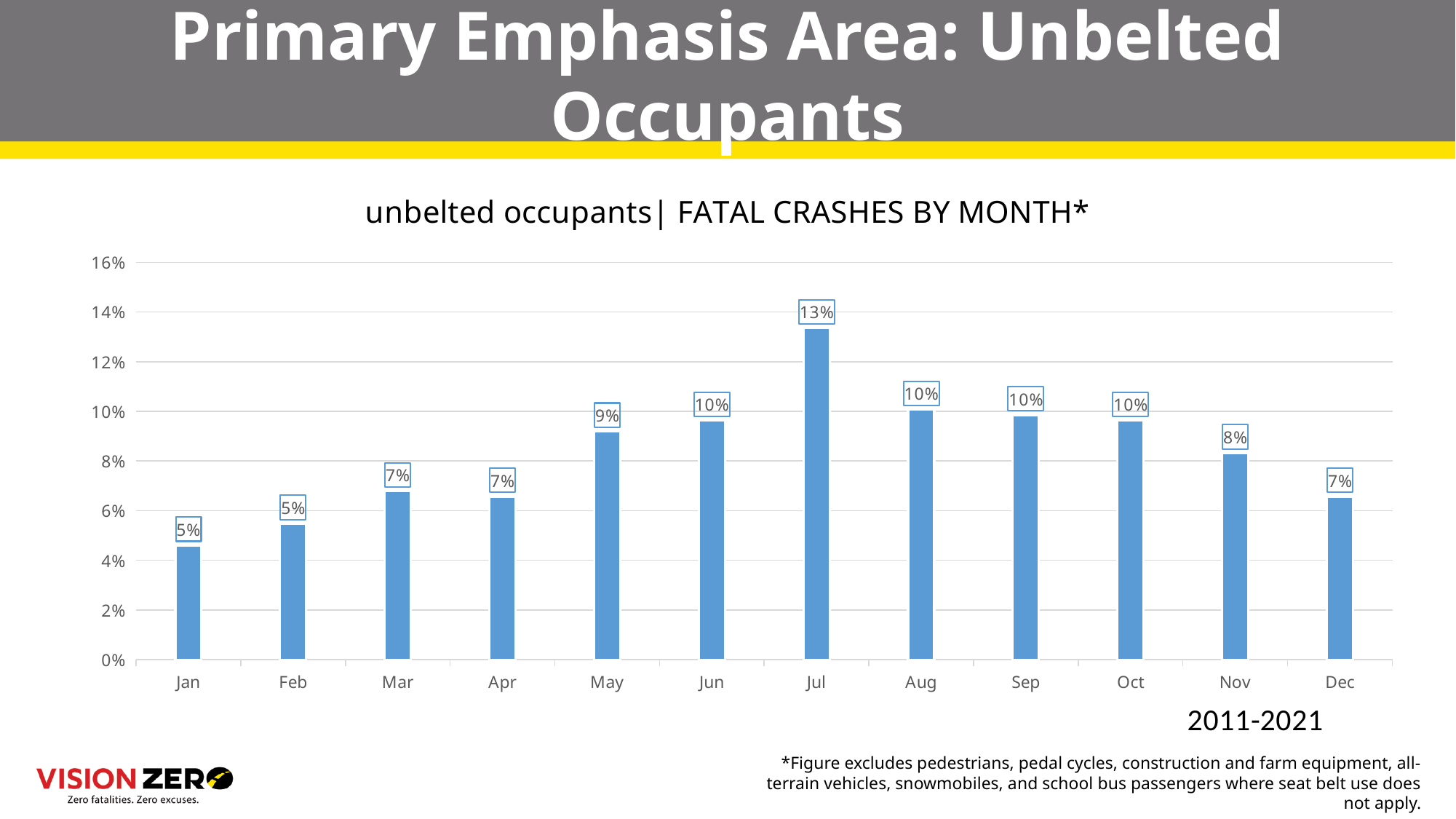
What kind of chart is shown on the slide? bar chart What is the value for Dec? 7% What is the value for Jul? 13% What is the value for Nov? 8% What is the difference between the values for Jul and Jan? 8% What is the difference between the values for Aug and Nov? 2% What is the value for May? 9% How many months are shown on the x axis? 12 Which month has the highest value? Jul Is the value for Jan greater or less than 6%? less Which is larger, the value for Jul or the value for Nov? Jul Do the values rise or fall from Jan to Jul? rise